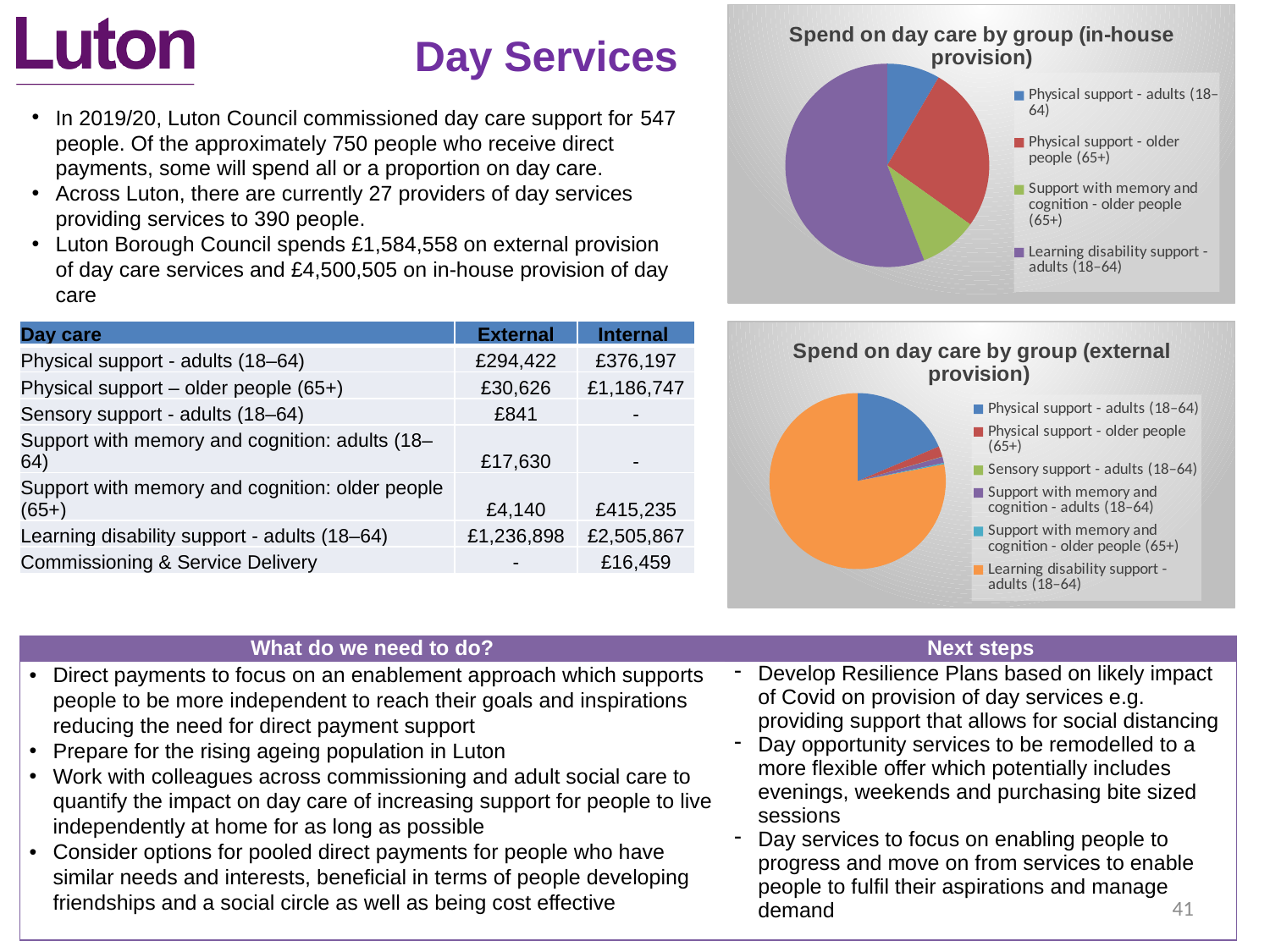
In the 'Spend on day care by group (external provision)' chart, what colour is the slice for Learning disability support - adults (18–64)? orange In the 'Spend on day care by group (in-house provision)' chart, which slice is larger: Learning disability support - adults (18–64) or Physical support - older people (65+)? Learning disability support - adults (18–64) In the 'Spend on day care by group (in-house provision)' chart, which slice is larger: Physical support - older people (65+) or Physical support - adults (18–64)? Physical support - older people (65+) In the 'Spend on day care by group (external provision)' chart, which slice is larger: Physical support - adults (18–64) or Physical support - older people (65+)? Physical support - adults (18–64) What type of chart is 'Spend on day care by group (external provision)'? pie chart What type of chart is 'Spend on day care by group (in-house provision)'? pie chart In the 'Spend on day care by group (in-house provision)' chart, what colour is the slice for Learning disability support - adults (18–64)? purple In the 'Spend on day care by group (external provision)' chart, how many groups does the legend list? 6 In the 'Spend on day care by group (in-house provision)' chart, which group has the largest slice? Learning disability support - adults (18–64) In the 'Spend on day care by group (in-house provision)' chart, how many groups does the legend list? 4 In the 'Spend on day care by group (external provision)' chart, which group has the largest slice? Learning disability support - adults (18–64)